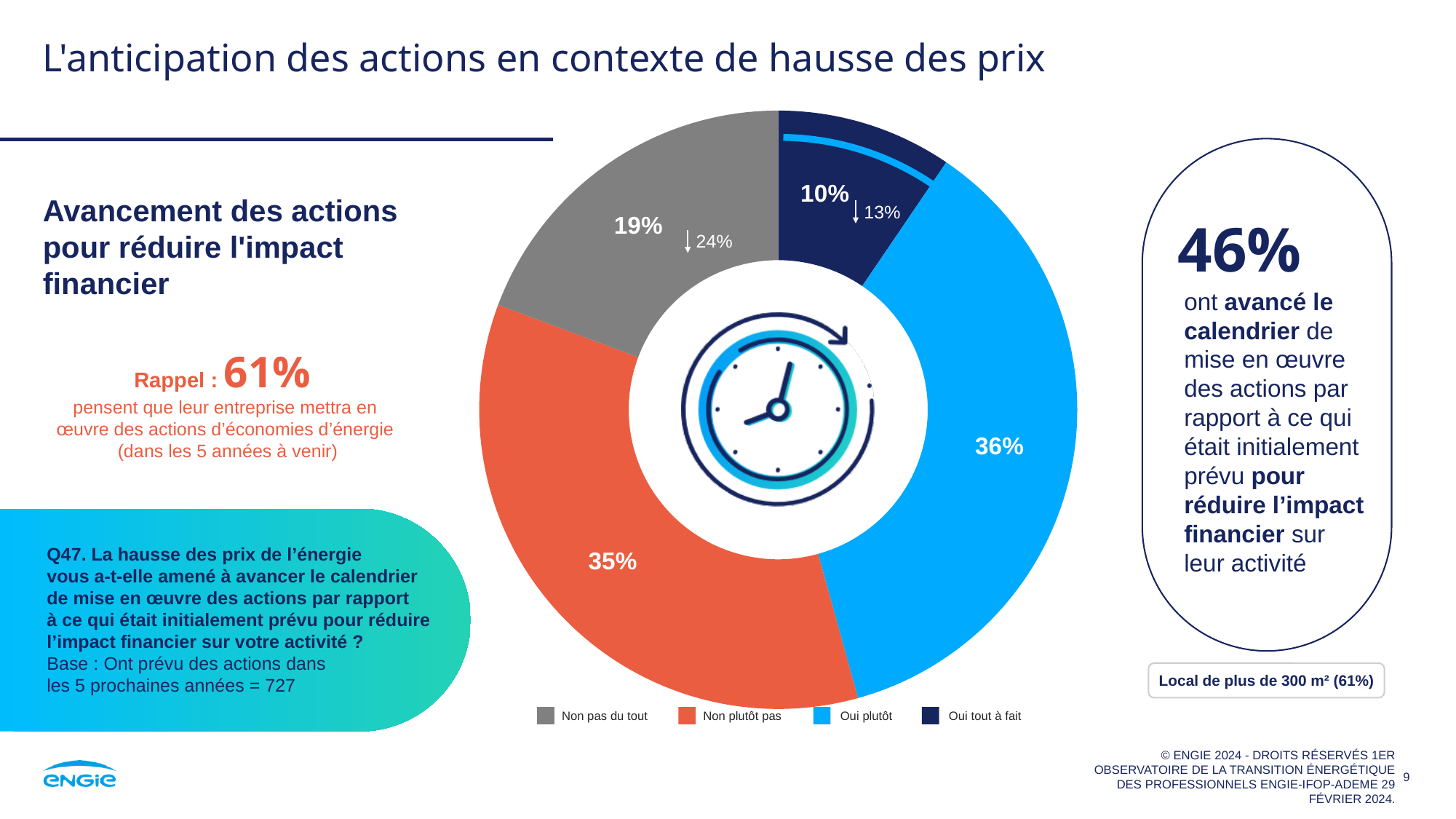
What type of chart is used on this slide? Donut (pie) chart Which response category has the smallest share in the donut chart? Oui tout à fait How many response categories are shown in the donut chart? 4 Which is larger in the donut chart: "Non pas du tout" or "Oui tout à fait"? Non pas du tout What percentage of respondents answered "Oui tout à fait" in the donut chart? 10% What is the combined share of the two "Oui" responses ("Oui plutôt" and "Oui tout à fait")? 46% What percentage of respondents answered "Non plutôt pas" in the donut chart? 35% What percentage of respondents answered "Oui plutôt" in the donut chart? 36% What percentage of respondents answered "Non pas du tout" in the donut chart? 19% What is the difference in percentage points between "Non plutôt pas" and "Non pas du tout"? 16 How many entries does the chart legend list? 4 Which colour represents "Non plutôt pas" in the donut chart? Orange/red